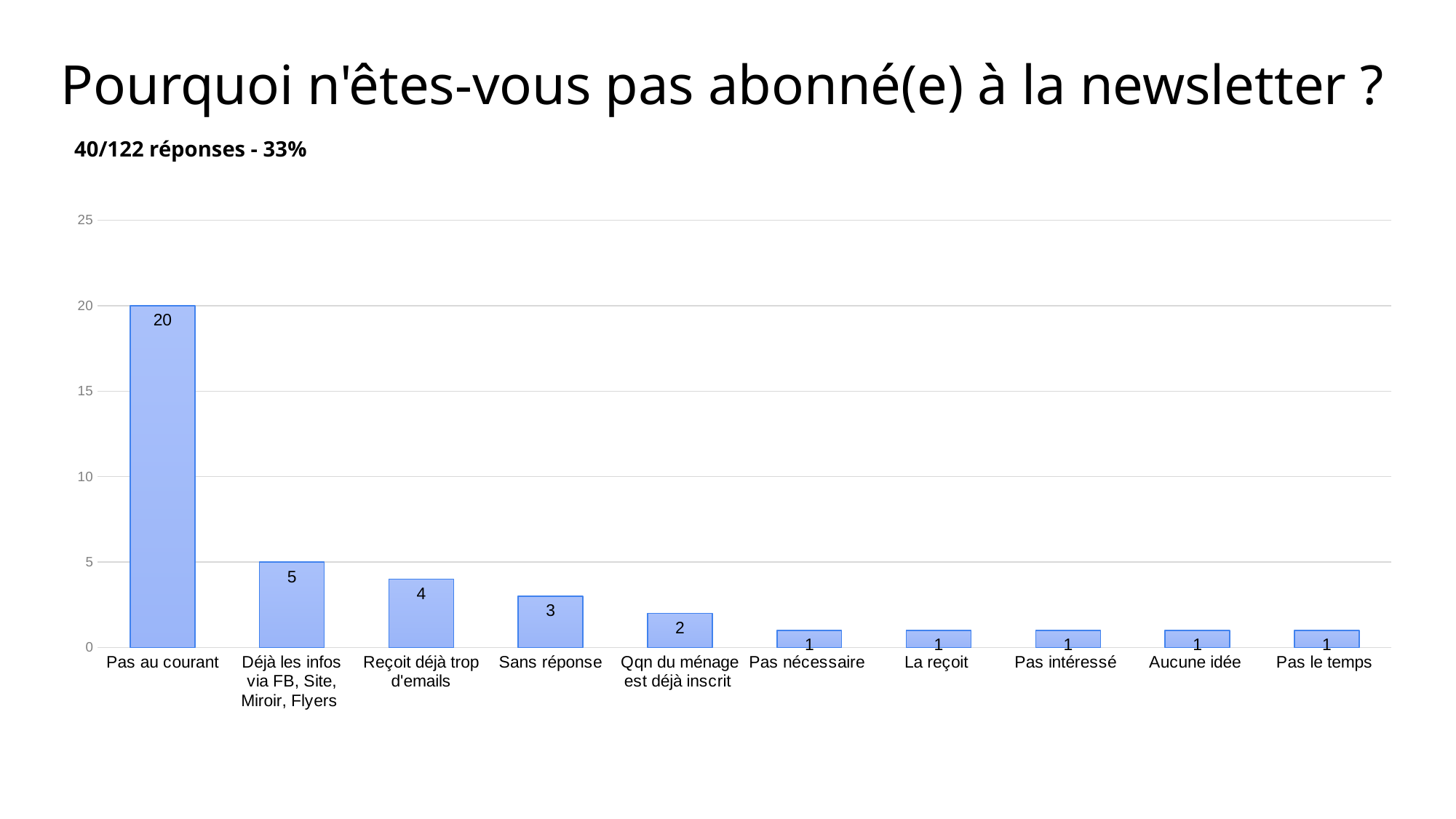
How many categories are shown on the x axis? 10 What is the value for "Sans réponse"? 3 What is the difference between "Déjà les infos via FB, Site, Miroir, Flyers" and "Sans réponse"? 2 What is the title of the slide? Pourquoi n'êtes-vous pas abonné(e) à la newsletter ? What is the value for "Reçoit déjà trop d'emails"? 4 What is the value for "Pas au courant"? 20 Which category has the highest value? Pas au courant Which is larger, "Reçoit déjà trop d'emails" or "Qqn du ménage est déjà inscrit"? Reçoit déjà trop d'emails Is the value for "Pas au courant" greater or less than 15? greater What is the difference between "Pas au courant" and "Déjà les infos via FB, Site, Miroir, Flyers"? 15 What is the value for "Qqn du ménage est déjà inscrit"? 2 What kind of chart is shown on the slide? bar chart